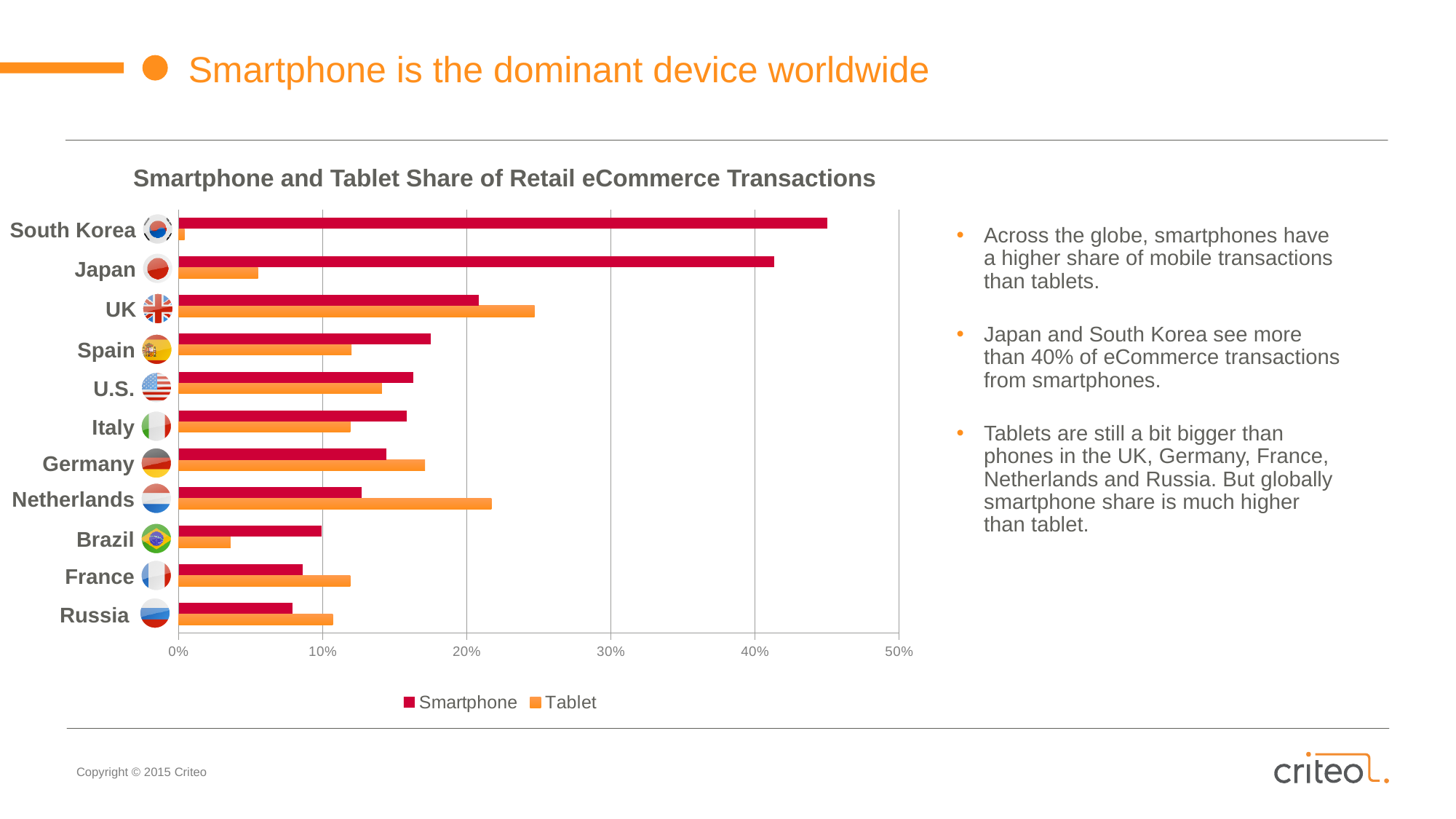
For the UK, which is larger: the Smartphone share or the Tablet share? Tablet What is the title of the chart? Smartphone and Tablet Share of Retail eCommerce Transactions How many countries are shown on the chart? 11 Is the Tablet value for UK greater or less than 20%? greater For Japan, which is larger: the Smartphone share or the Tablet share? Smartphone How many series does the legend list? 2 Which country has the highest Smartphone share? South Korea Is the Tablet value for Brazil greater or less than 10%? less What kind of chart is shown on the slide? Bar chart Is the Smartphone value for South Korea greater or less than 40%? greater Which country has the highest Tablet share? UK Which country has the lowest Tablet share? South Korea